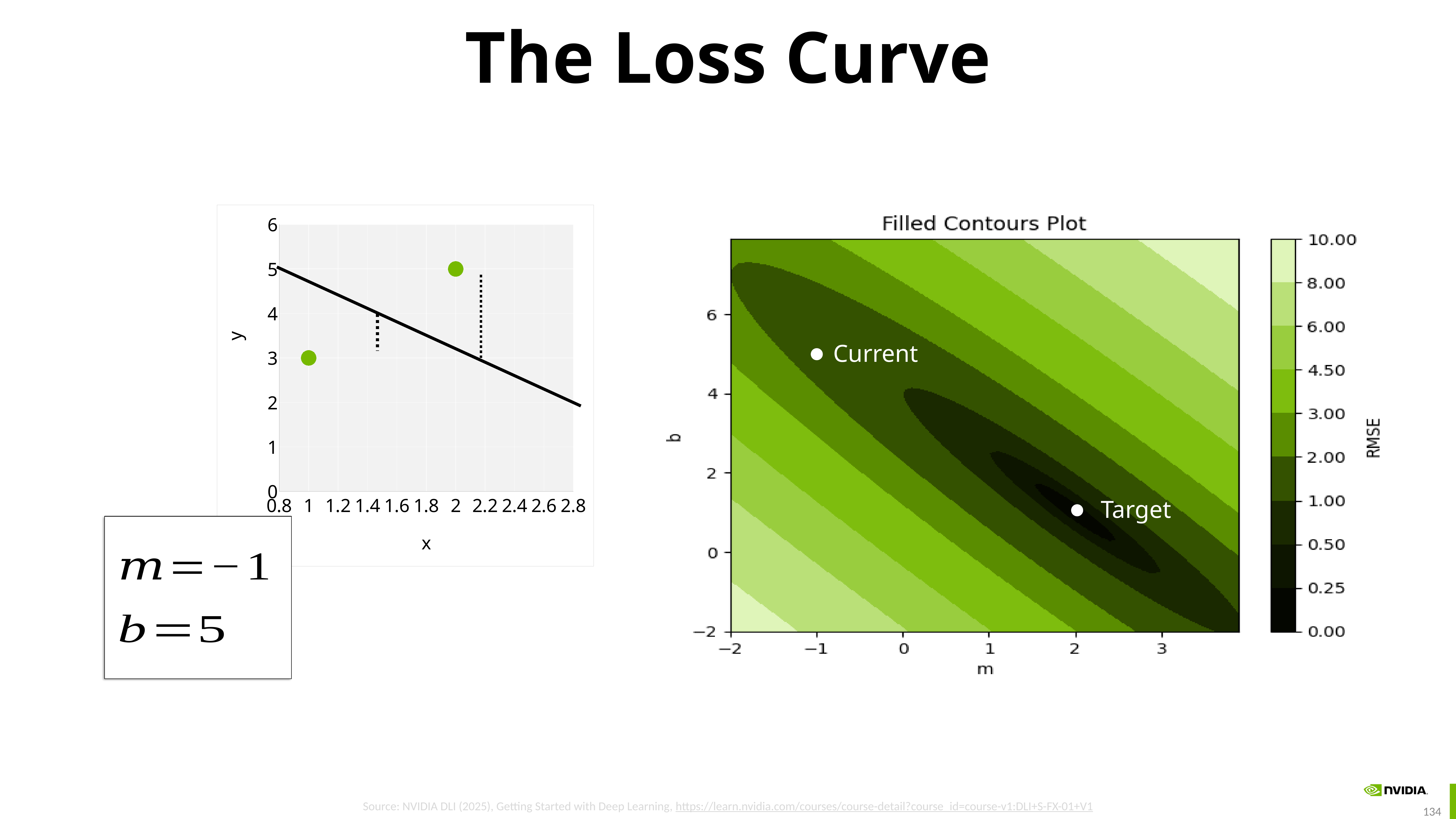
In the Filled Contours Plot, which point has the larger b value, Current or Target? Current In the chart on the left, what is the difference in y between the point at x = 2 and the point at x = 1? 2 In the chart on the left, does the fitted line rise or fall as x increases? fall In the chart on the left, which data point has the higher y value, the one at x = 1 or the one at x = 2? x = 2 In the chart on the left, what is the y value of the data point at x = 1? 3 In the Filled Contours Plot, what is the m coordinate of the point labelled Current? -1 In the Filled Contours Plot, what quantity does the colour bar represent? RMSE In the chart on the left, how many data points are plotted? 2 In the chart on the left, what is the y value of the data point at x = 2? 5 What is the title of the chart on the right of the slide? Filled Contours Plot What kind of chart is the chart on the left of the slide? scatter plot